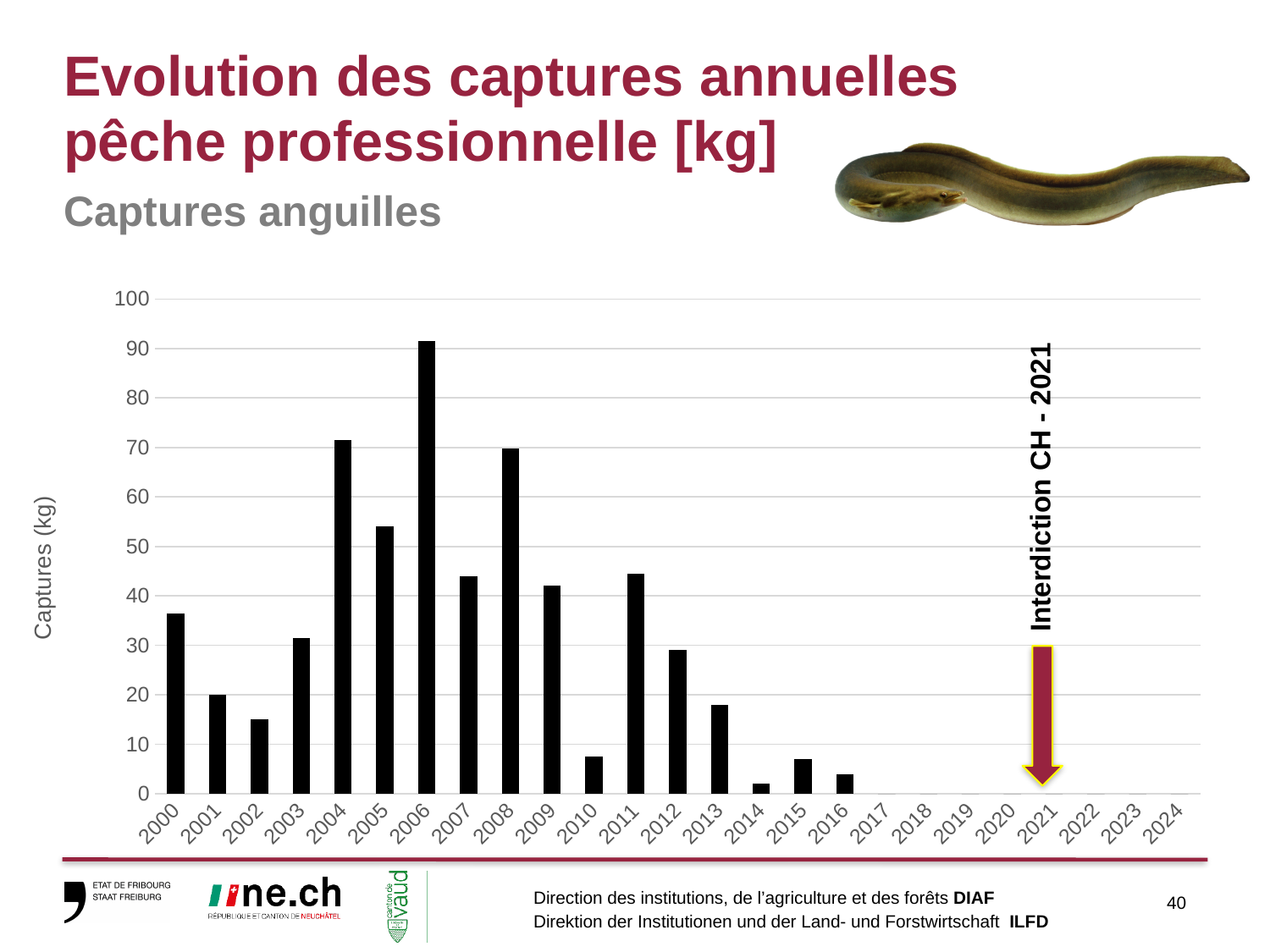
How many years are labelled on the x axis? 25 Is the value for 2004 greater or less than 70? greater Which year has the highest catch value in the chart? 2006 What is the label of the y axis? Captures (kg) What kind of chart is shown on the slide? bar chart Which year has the larger value, 2002 or 2003? 2003 Do the values rise or fall from 2011 to 2016? fall Is the value for 2006 greater or less than 90? greater Which year has the larger value, 2005 or 2007? 2005 Is the value for 2010 greater or less than 10? less